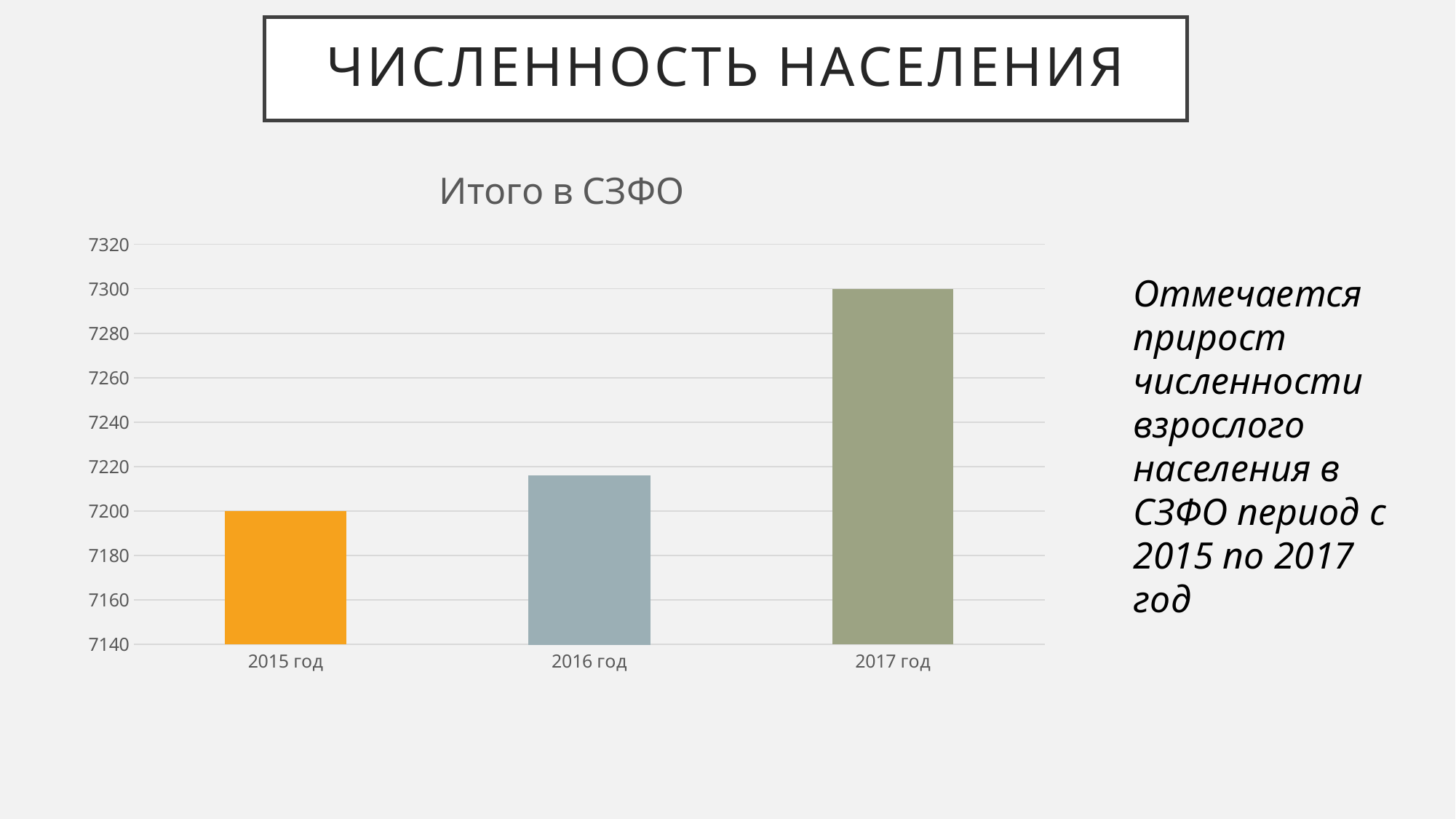
Which is larger, the value for 2016 год or the value for 2017 год? 2017 год How many bars (categories) does the chart show? 3 What is the title of the chart? Итого в СЗФО Which year has the highest value? 2017 год What is the difference between the values for 2017 год and 2015 год? 100 What is the value for 2015 год? 7200 Is the value for 2016 год greater or less than 7220? less Which year has the lowest value? 2015 год What is the value for 2017 год? 7300 What kind of chart is shown on the slide? bar chart Is the value for 2016 год greater or less than 7200? greater Do the values rise or fall from 2015 год to 2017 год? rise